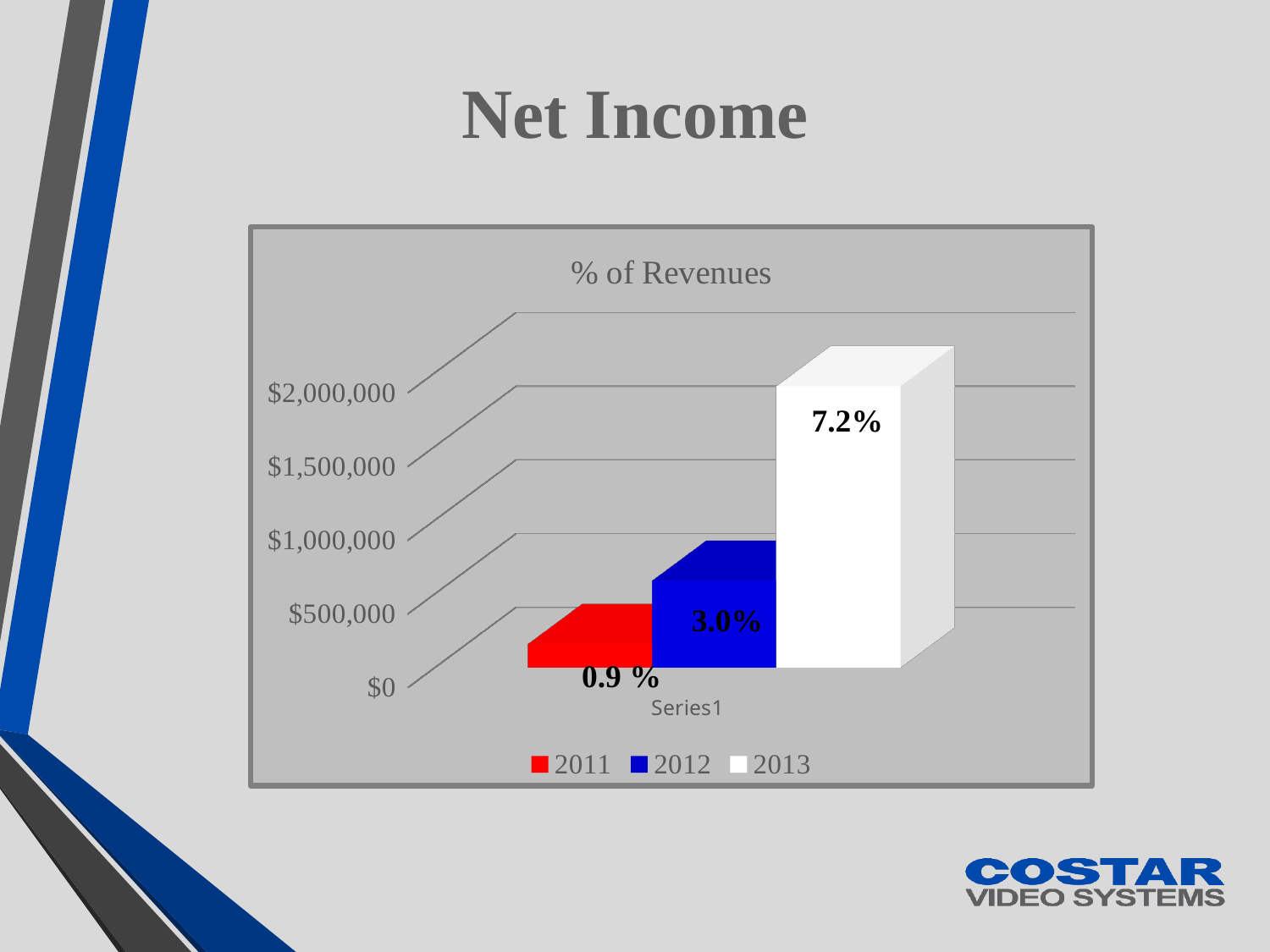
What data label is shown on the 2012 bar? 3.0% What data label is shown on the 2011 bar? 0.9 % What data label is shown on the 2013 bar? 7.2% What kind of chart is shown on the slide? bar chart What is the difference between the percentage labels for 2013 and 2011? 6.3% Which year has the tallest bar? 2013 Is the value for the 2012 bar greater or less than $500,000? greater What is the title of the chart? % of Revenues Is the value for the 2011 bar greater or less than $500,000? less How many series does the legend list? 3 Which year has the shortest bar? 2011 Which bar is taller, 2012 or 2011? 2012